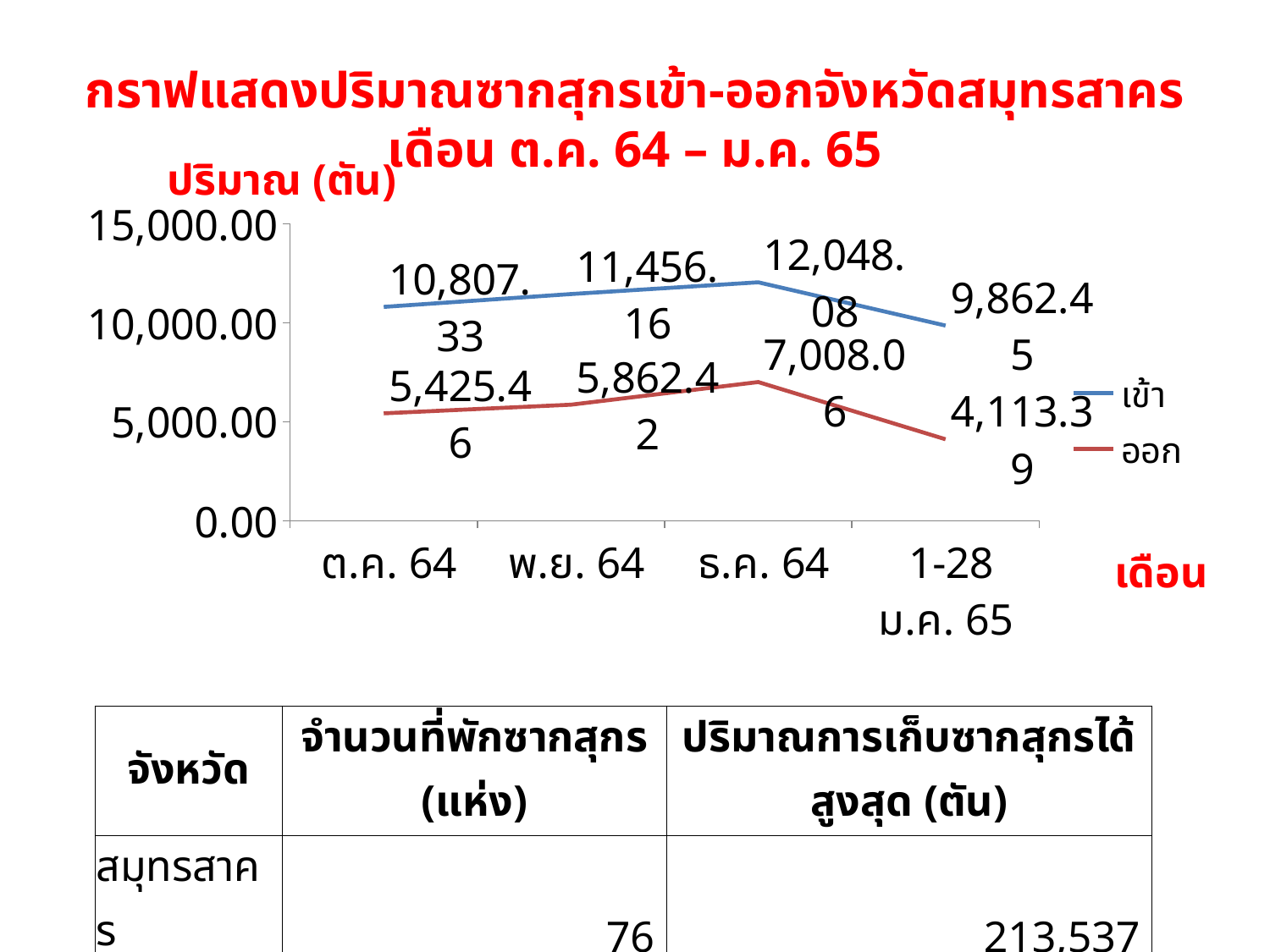
How many months (categories) are plotted on the x axis of the chart? 4 What is the value of the เข้า series for ธ.ค. 64? 12,048.08 In which month is the เข้า series lowest? 1-28 ม.ค. 65 What is the value of the ออก series for ต.ค. 64? 5,425.46 What is the difference between the เข้า and ออก values for พ.ย. 64? 5,593.74 What is the label of the y axis of the chart? ปริมาณ (ตัน) In which month is the ออก series highest? ธ.ค. 64 Which is larger: the ออก value for ธ.ค. 64 or the ออก value for พ.ย. 64? ธ.ค. 64 How many series does the chart legend list? 2 Does the เข้า series rise or fall from ธ.ค. 64 to 1-28 ม.ค. 65? fall What is the value of the เข้า series for 1-28 ม.ค. 65? 9,862.45 What type of chart is shown on the slide? line chart